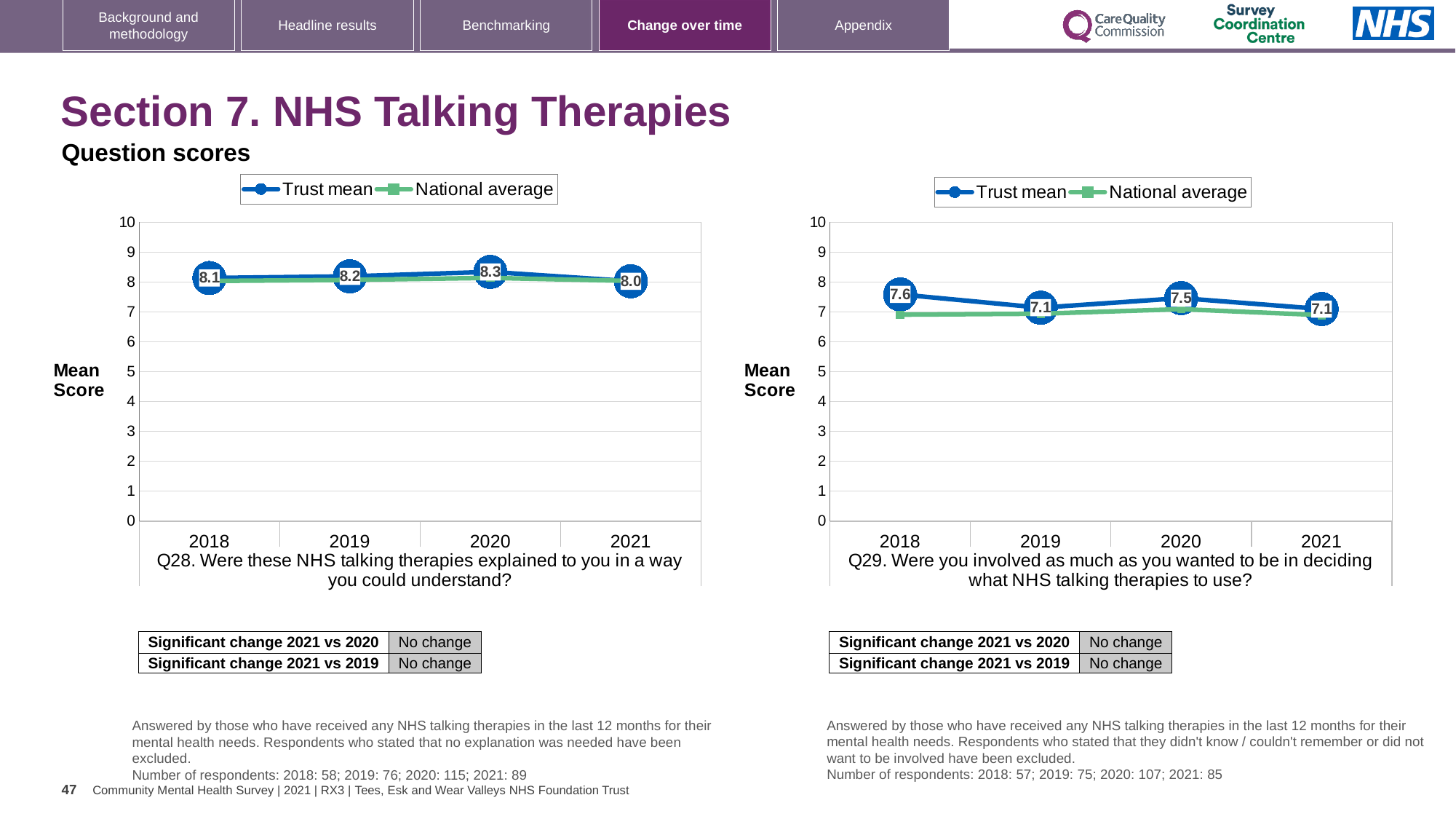
In the Q29 chart (right), what is the Trust mean score for 2018? 7.6 In the Q29 chart (right), is the Trust mean score for 2018 greater or less than 7? greater In the Q28 chart (left), is the Trust mean score for 2019 larger or smaller than the Trust mean score for 2021? larger In the Q29 chart (right), what is the Trust mean score for 2020? 7.5 How many years are plotted on the x axis of the Q28 chart (left)? 4 How many series does the legend of the Q29 chart (right) list? 2 In the Q28 chart (left), which year has the highest Trust mean score? 2020 In the Q29 chart (right), which year has the highest Trust mean score? 2018 In the Q29 chart (right), what is the difference between the Trust mean scores for 2018 and 2019? 0.5 In the Q28 chart (left), which year has the lowest Trust mean score? 2021 In the Q28 chart (left), what is the Trust mean score for 2020? 8.3 In the Q28 chart (left), what is the Trust mean score for 2021? 8.0